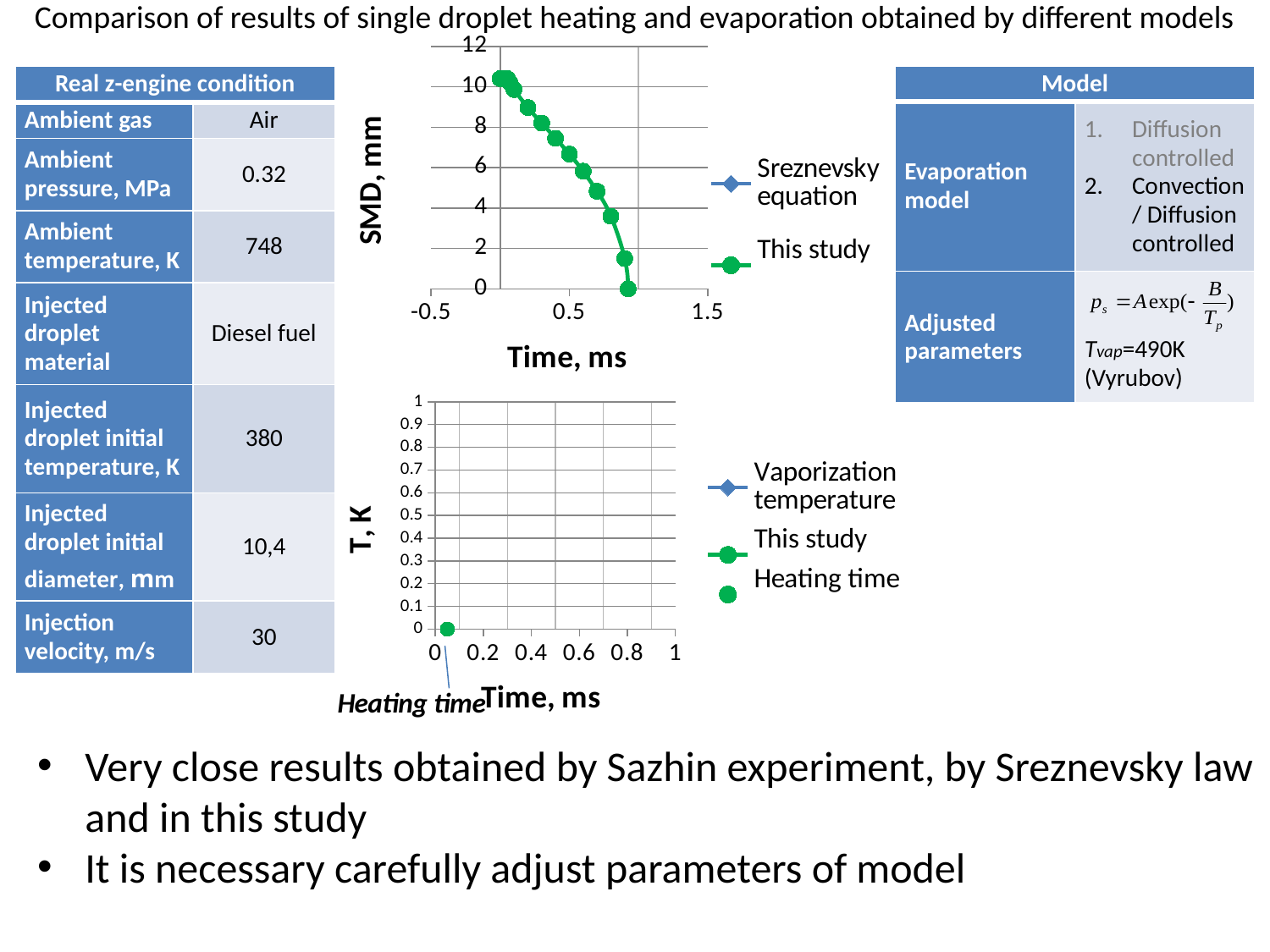
In the top chart (SMD vs Time), is the SMD value at time 0 ms greater or less than 8? greater In the top chart (SMD vs Time), do the SMD values rise or fall as time increases? fall In the top chart (SMD vs Time), what is the label of the vertical axis? SMD, mm In the top chart (SMD vs Time), what is the highest tick value shown on the vertical axis? 12 In the bottom chart (T vs Time), how many series does the legend list? 3 In the top chart (SMD vs Time), how many series does the legend list? 2 In the top chart (SMD vs Time), what kind of chart is it? line chart In the top chart (SMD vs Time), what are the two legend entries? Sreznevsky equation; This study In the bottom chart (T vs Time), what is the highest tick value shown on the horizontal axis? 1 In the top chart (SMD vs Time), is the SMD value at time 0.5 ms greater or less than 8? less In the top chart (SMD vs Time), is the SMD value at time 0.5 ms greater or less than 4? greater In the top chart (SMD vs Time), what is the SMD value of the final plotted point? 0